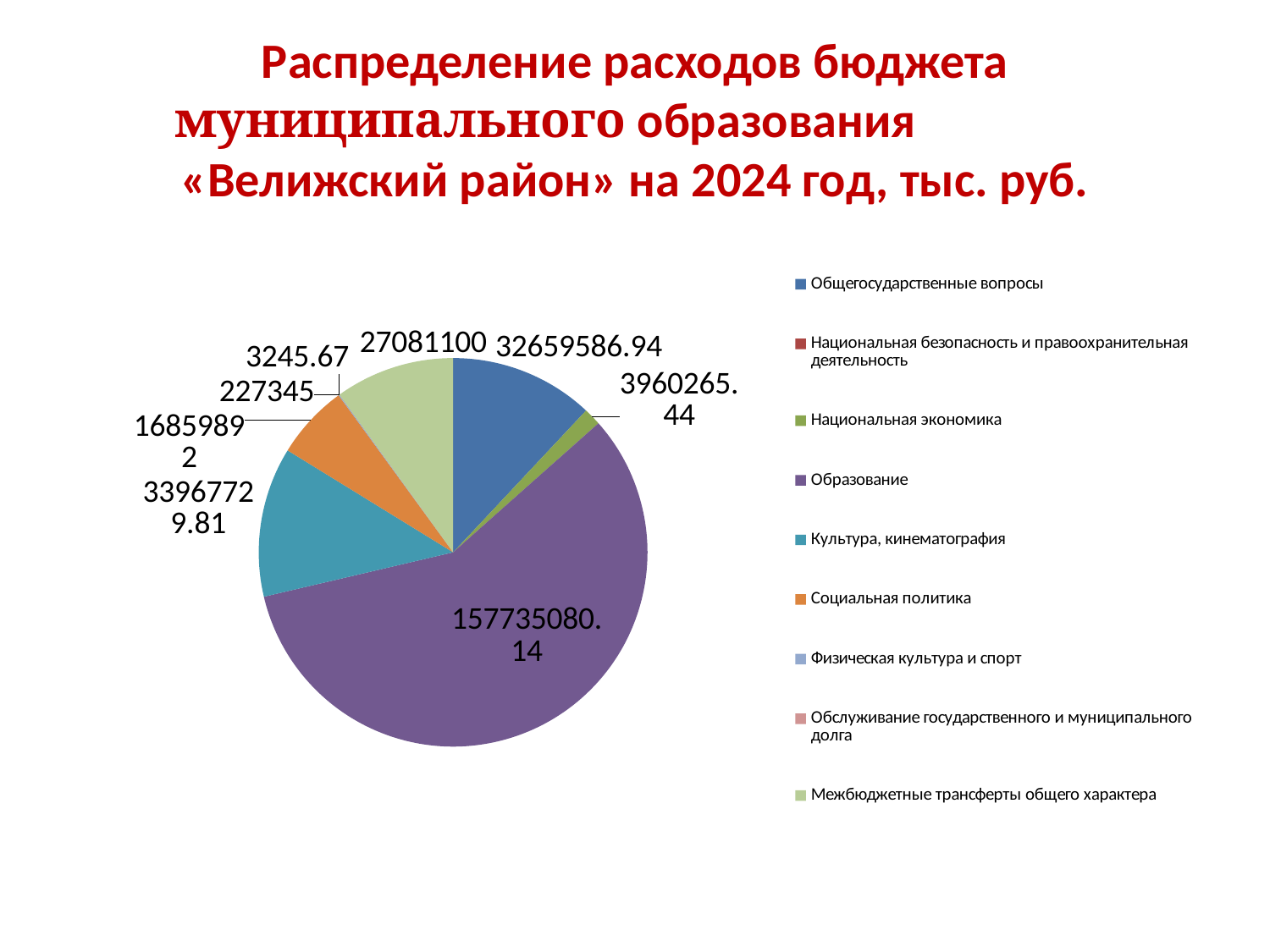
What is the value for Культура, кинематография? 33967729.81 What is the value for Межбюджетные трансферты общего характера? 27081100 How many categories does the legend list? 9 Which is larger, Образование or Культура, кинематография? Образование What is the value for Общегосударственные вопросы? 32659586.94 What is the value for Образование? 157735080.14 What is the difference between Культура, кинематография and Общегосударственные вопросы? 1308142.87 What is the value for Социальная политика? 16859892 What is the value for Национальная экономика? 3960265.44 What kind of chart is shown on the slide? pie chart Which category has the largest slice of the pie? Образование What colour is the slice for Образование? purple